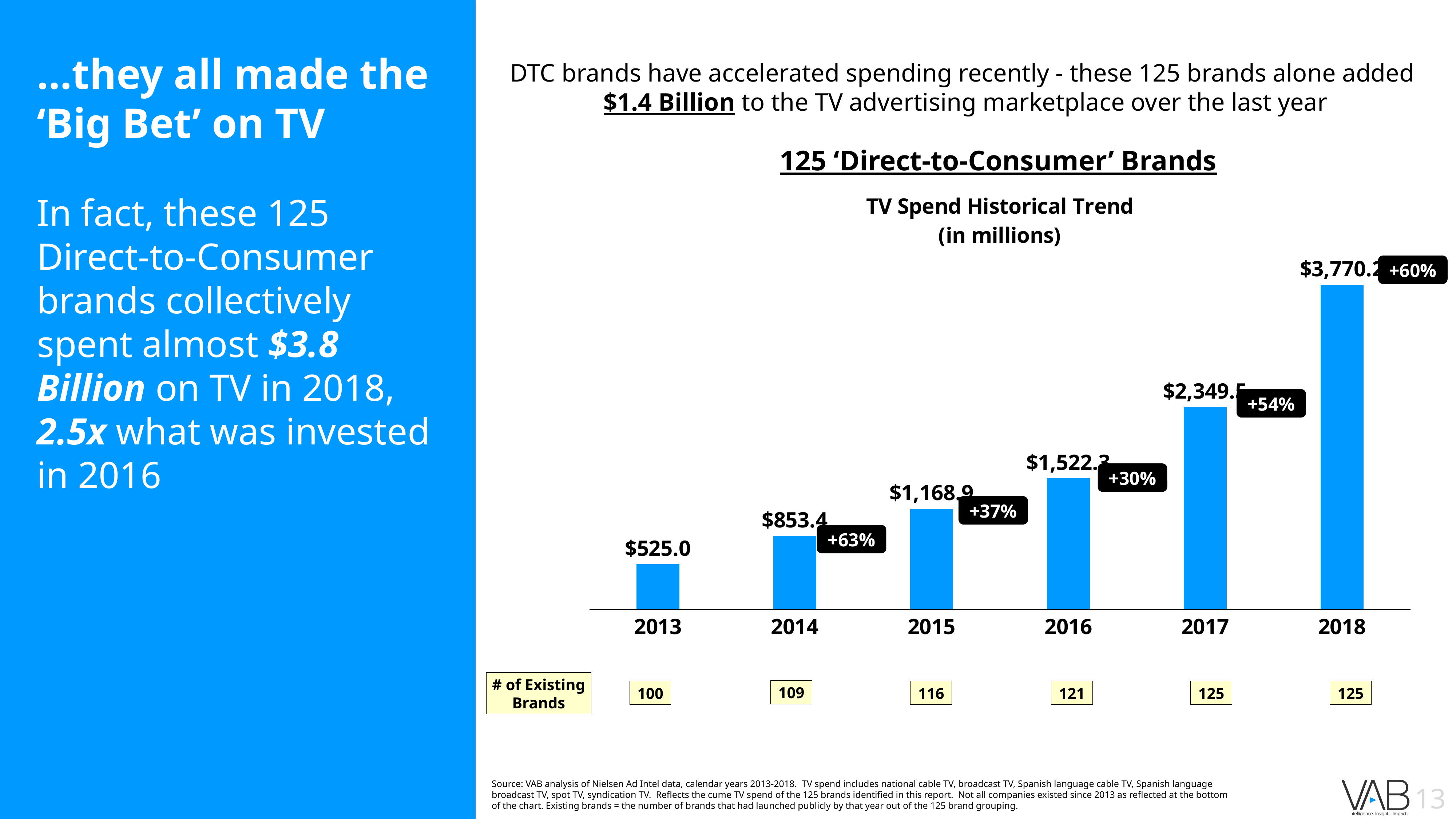
Which year has the lowest TV spend in the chart? 2013 Which year had higher TV spend, 2015 or 2016? 2016 How many existing brands are listed below the chart for 2016? 121 How many years are shown in the TV Spend Historical Trend chart? 6 What was the TV spend for 2014 in the TV Spend Historical Trend chart? $853.4 What year-over-year growth percentage is labelled on the 2014 bar? +63% What is the difference in TV spend between 2014 and 2013? $328.4 What was the TV spend for 2013 in the TV Spend Historical Trend chart? $525.0 What was the TV spend for 2015 in the TV Spend Historical Trend chart? $1,168.9 What type of chart is the TV Spend Historical Trend chart? Bar chart Which year has the highest TV spend in the chart? 2018 Do the TV spend values rise or fall from 2013 to 2018? Rise